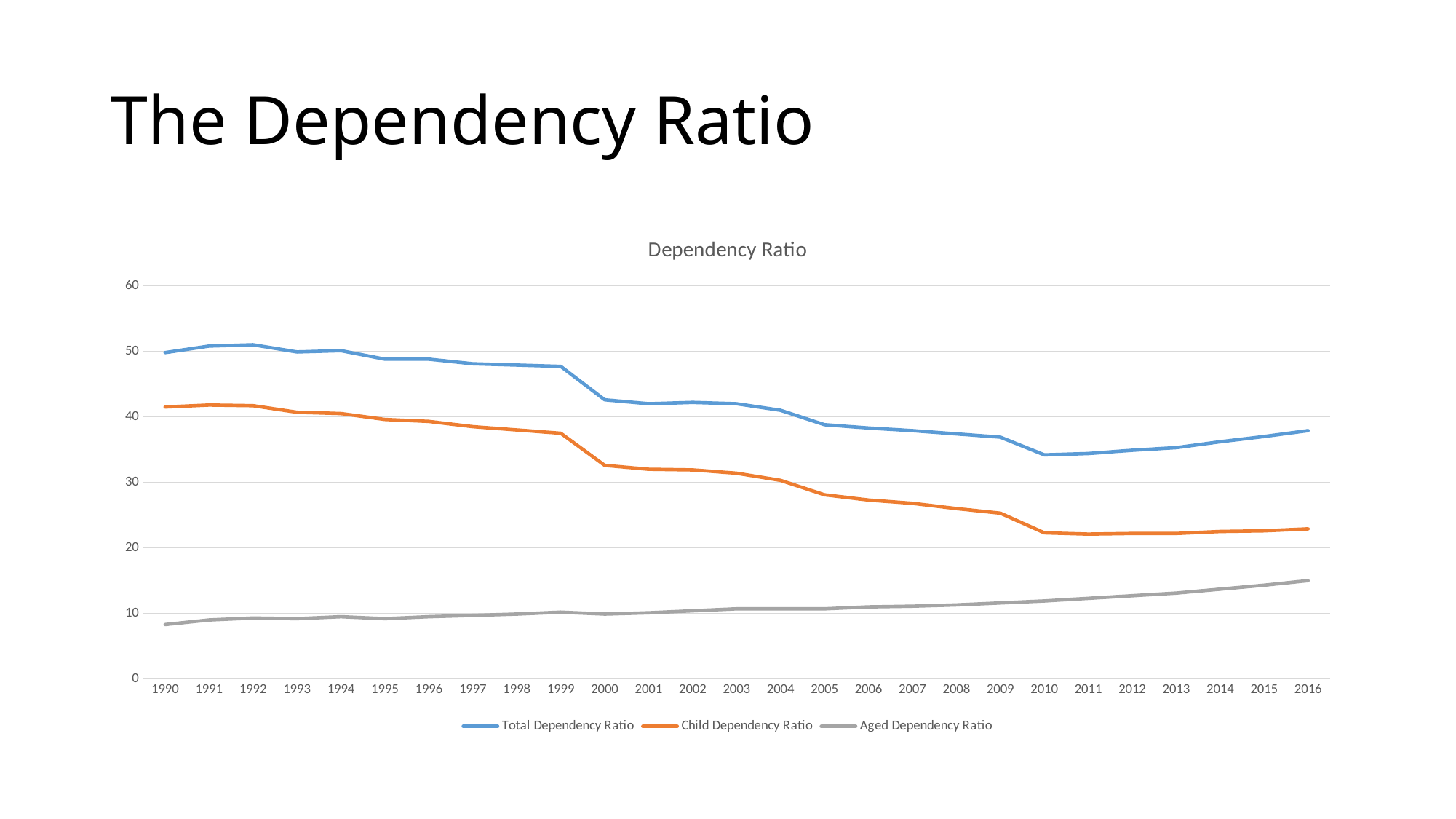
In 2016, which is larger: the Child Dependency Ratio or the Aged Dependency Ratio? Child Dependency Ratio Does the Child Dependency Ratio rise or fall from 1990 to 2010? Fall Does the Aged Dependency Ratio rise or fall from 1990 to 2016? Rise How many years are plotted along the x axis? 27 What kind of chart is shown on the slide? Line chart In which year is the Aged Dependency Ratio highest? 2016 Which series is drawn in grey? Aged Dependency Ratio In which year is the Aged Dependency Ratio lowest? 1990 Is the Aged Dependency Ratio in 1990 greater or less than 10? less What is the title of the chart? Dependency Ratio Is the Total Dependency Ratio in 2010 greater or less than 40? less How many series does the legend list? 3